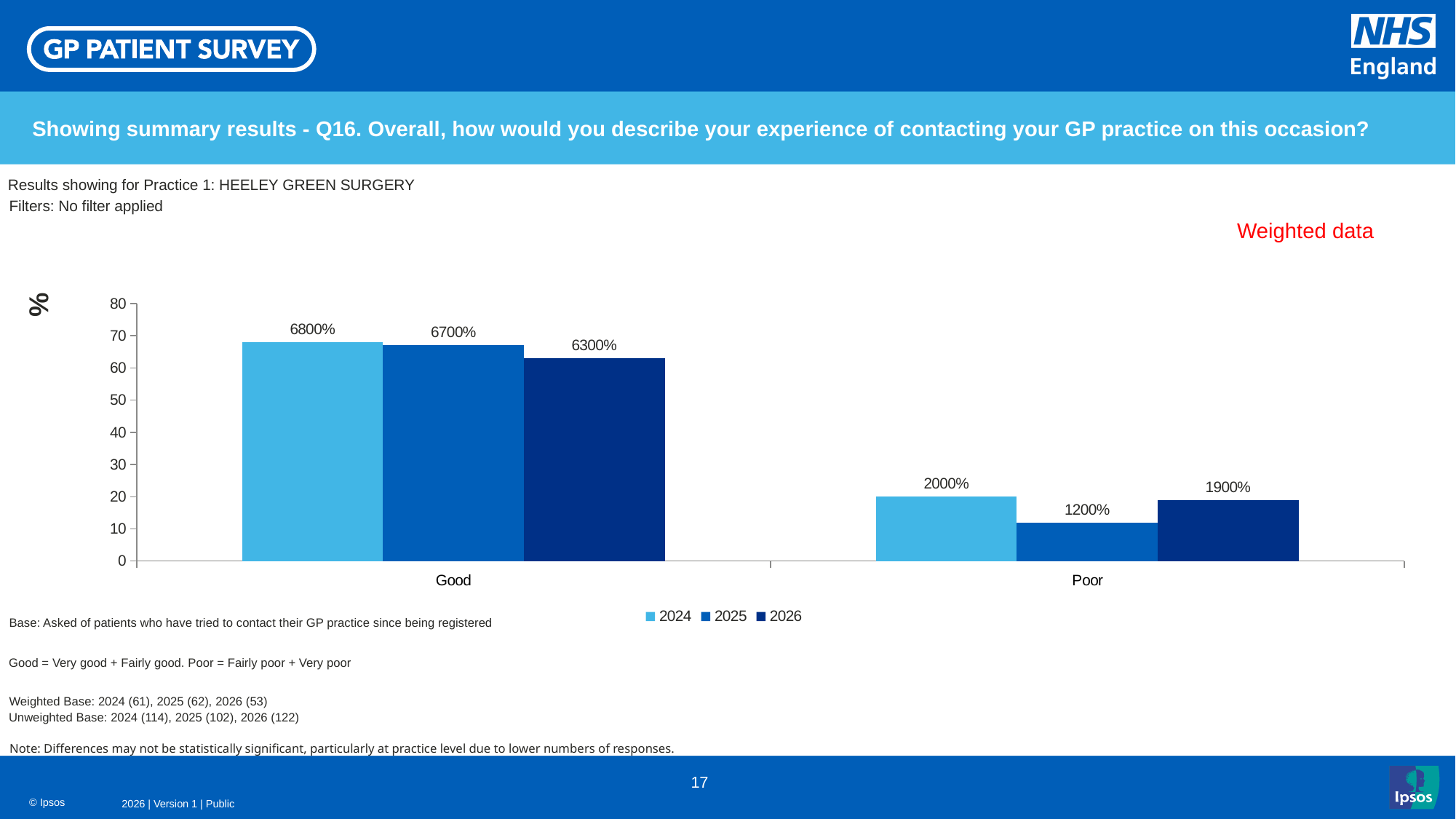
Which practice are the results shown for? HEELEY GREEN SURGERY What is the data label shown for the 2025 bar in the Good category? 6700% What is the data label shown for the 2026 bar in the Poor category? 1900% Is the 2024 bar or the 2026 bar larger in the Poor category? 2024 How many categories are shown on the x axis? 2 What kind of chart is shown on the slide? Bar chart Which year has the highest bar in the Good category? 2024 What is the data label shown for the 2024 bar in the Good category? 6800% Is the value for 2026 in the Good category greater or less than 60 on the axis? greater What is the data label shown for the 2025 bar in the Poor category? 1200% How many series does the legend list? 3 Which year has the lowest bar in the Poor category? 2025